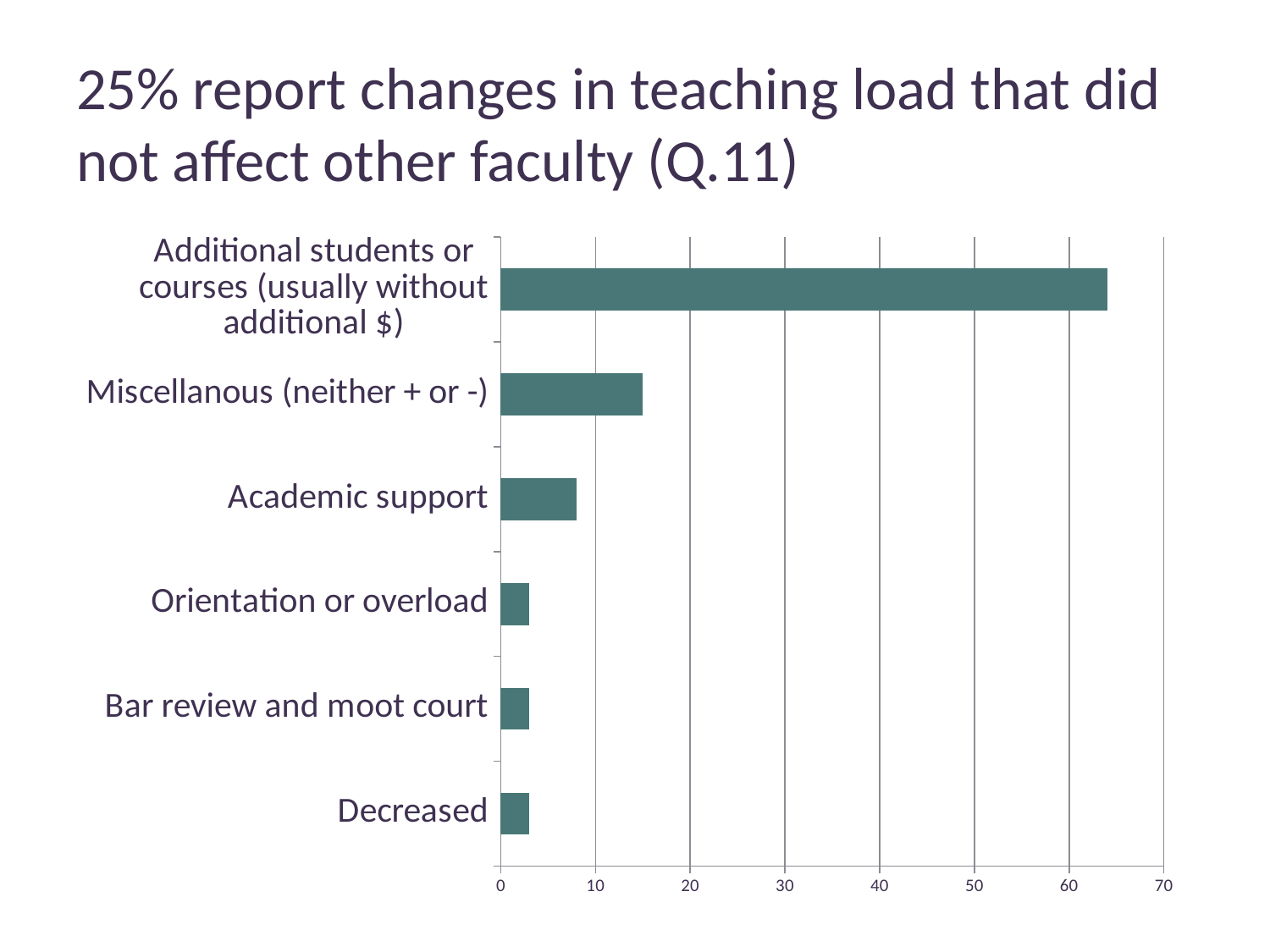
Is the value for Miscellanous (neither + or -) greater or less than 10? greater What kind of chart is shown on the slide? bar chart Which is larger, the value for Academic support or the value for Orientation or overload? Academic support Is the value for Decreased greater or less than 10? less Which is larger, the value for Miscellanous (neither + or -) or the value for Academic support? Miscellanous (neither + or -) What is the maximum value shown on the horizontal axis? 70 Is the value for Academic support greater or less than 10? less How many categories are plotted in the chart? 6 Which category has the highest value? Additional students or courses (usually without additional $) What is the title of the slide containing the chart? 25% report changes in teaching load that did not affect other faculty (Q.11)